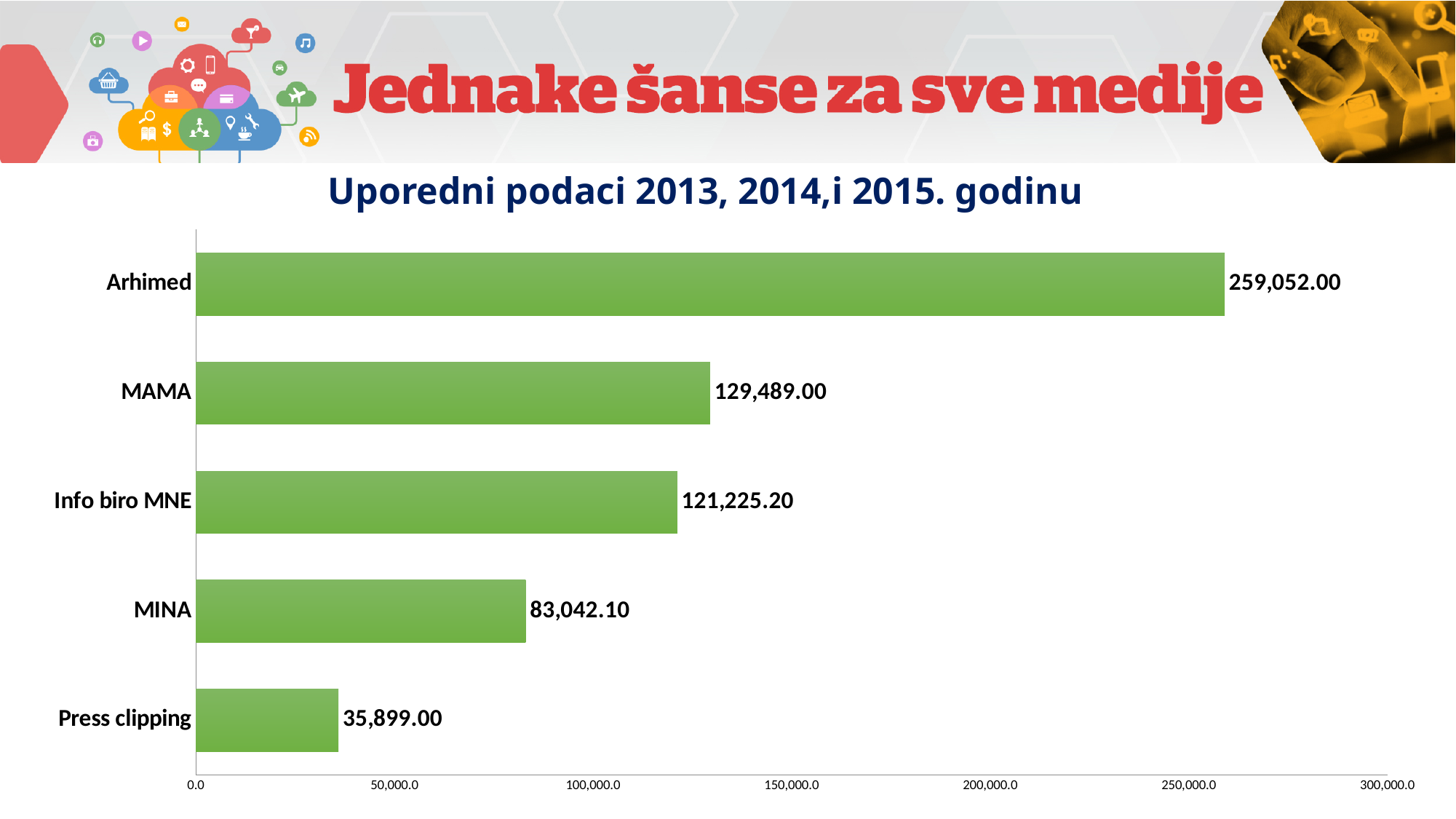
What is the value for Press clipping? 35,899.00 Which is larger, the value for MAMA or the value for Info biro MNE? MAMA What is the value for Info biro MNE? 121,225.20 Which category has the highest value? Arhimed Is the value for MINA greater or less than 100,000.0? less What is the value for Arhimed? 259,052.00 What is the difference between the values for Arhimed and MAMA? 129,563.00 How many categories are shown in the chart? 5 What is the title of the chart? Uporedni podaci 2013, 2014,i 2015. godinu What kind of chart is shown on the slide? bar chart What is the difference between the values for MINA and Press clipping? 47,143.10 Which category has the lowest value? Press clipping